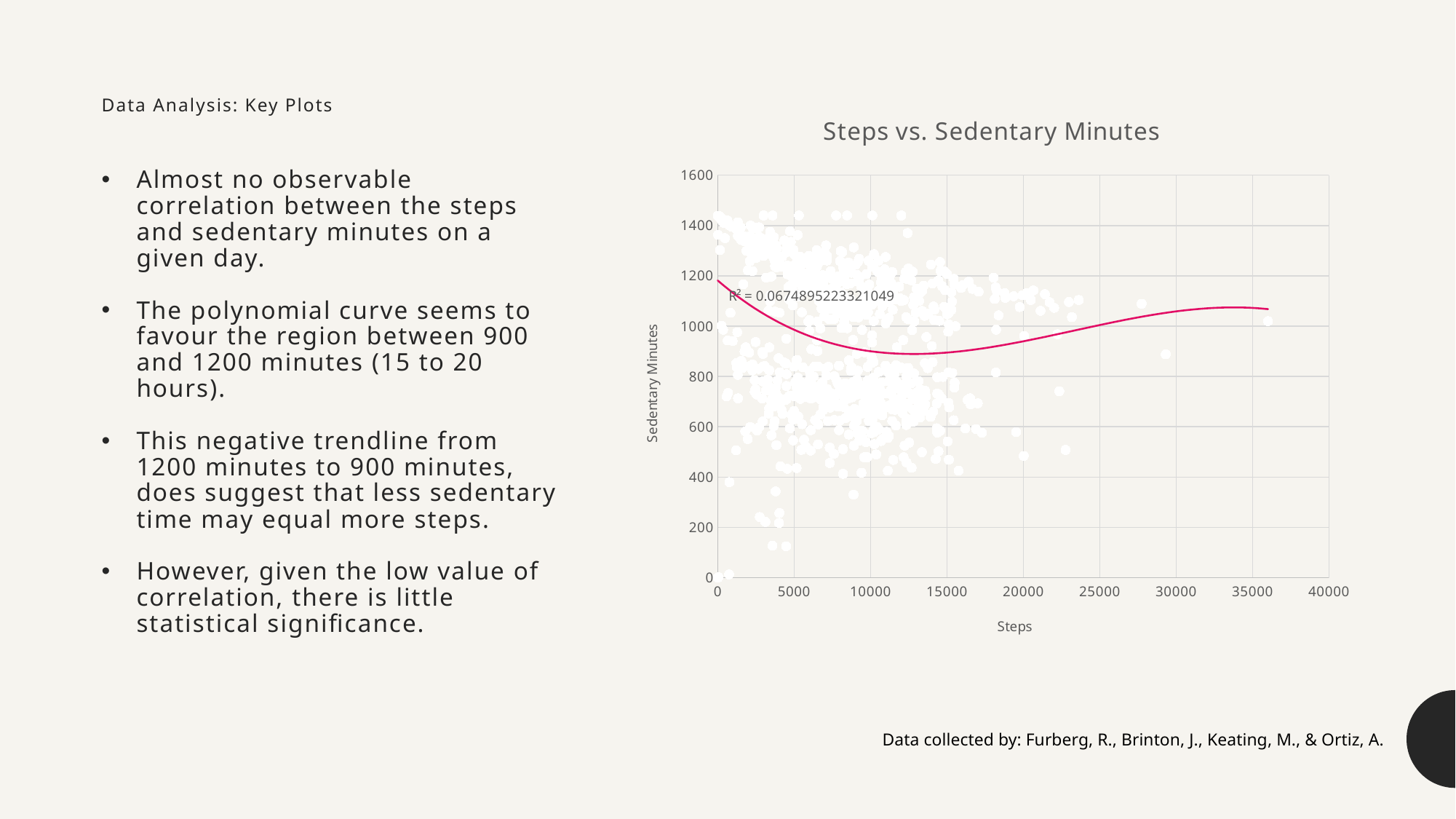
What R² value is printed on the chart? R² = 0.0674895223321049 What is the label of the x axis of the chart? Steps What is the title of the chart? Steps vs. Sedentary Minutes Does the trendline rise or fall between 15000 and 30000 steps? Rise Is the value of the trendline at 35000 steps greater or less than 1000 sedentary minutes? greater What kind of chart is shown on the slide? Scatter chart What is the highest tick value shown on the x axis of the chart? 40000 Is the value of the trendline at 0 steps greater or less than 1000 sedentary minutes? greater What is the highest tick value shown on the y axis of the chart? 1600 Is the lowest point of the trendline, near 12500 steps, greater or less than 1000 sedentary minutes? less Does the trendline fall or rise between 0 and 10000 steps? Fall